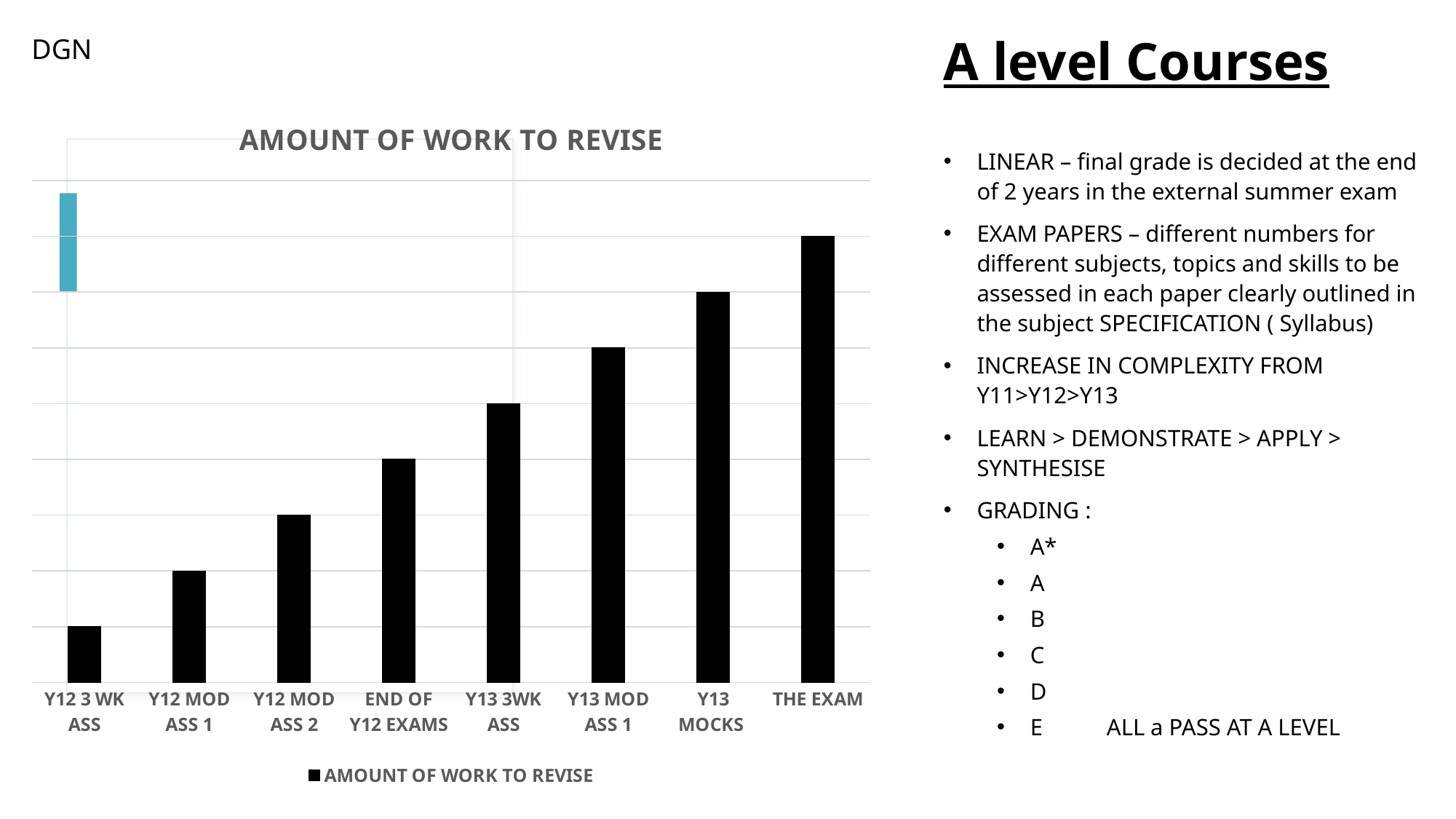
What is the title of the chart on the slide? AMOUNT OF WORK TO REVISE Which is larger, the bar for Y13 3WK ASS or the bar for Y13 MOD ASS 1? Y13 MOD ASS 1 How many categories are plotted along the x axis of the chart? 8 What series name is shown in the chart legend? AMOUNT OF WORK TO REVISE How many series does the chart legend list? 1 What type of chart is shown under the title "AMOUNT OF WORK TO REVISE"? Bar chart Which is larger, the bar for Y12 MOD ASS 1 or the bar for Y12 MOD ASS 2? Y12 MOD ASS 2 Which category has the lowest bar in the "AMOUNT OF WORK TO REVISE" chart? Y12 3 WK ASS Which is larger, the bar for Y13 MOCKS or the bar for END OF Y12 EXAMS? Y13 MOCKS Which category has the highest bar in the "AMOUNT OF WORK TO REVISE" chart? THE EXAM Do the bars rise or fall moving from left to right along the x axis? Rise